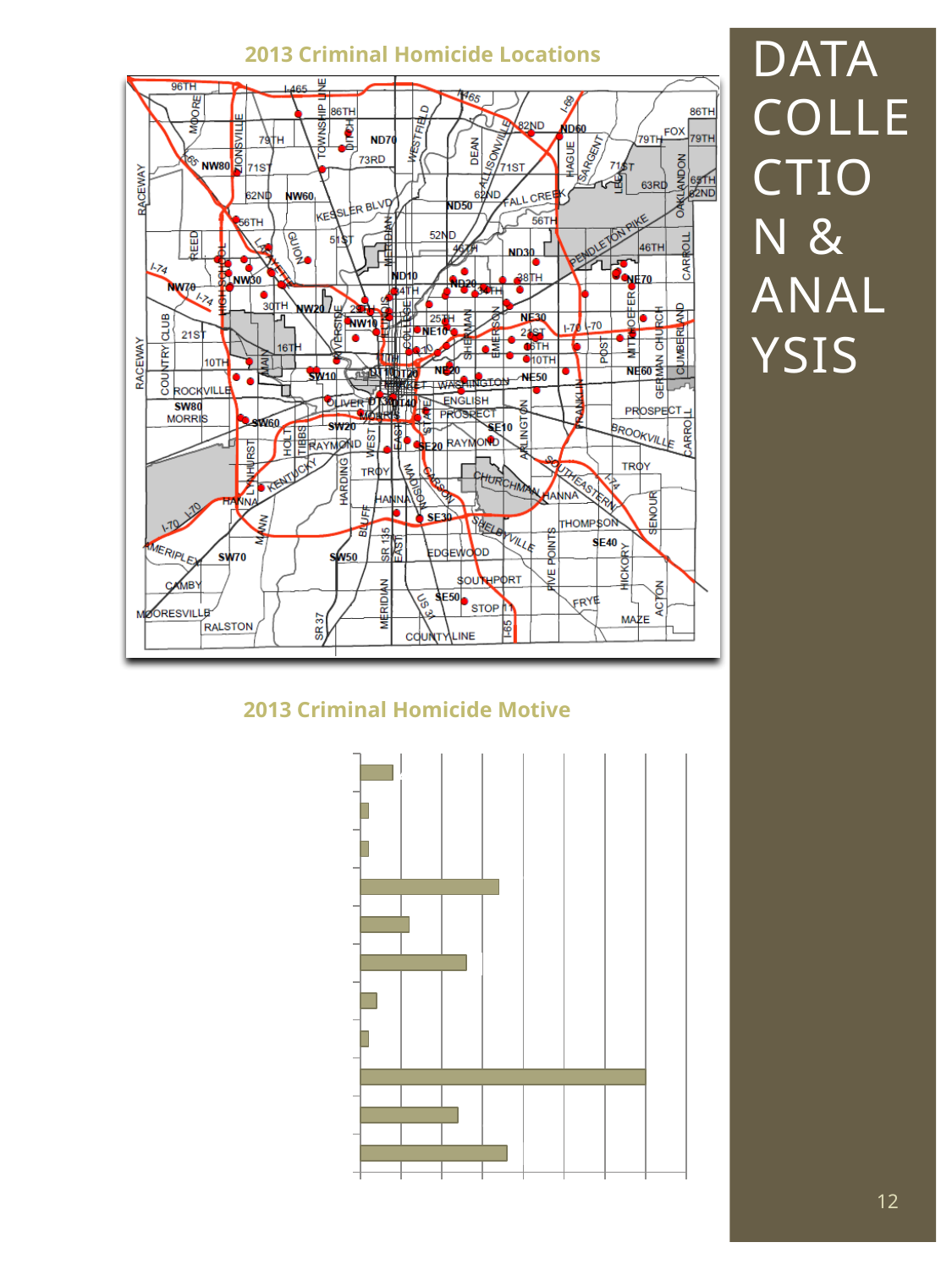
What kind of chart is the '2013 Criminal Homicide Motive' chart? bar chart What is the title of the bar chart at the bottom of the slide? 2013 Criminal Homicide Motive How many bars are plotted in the '2013 Criminal Homicide Motive' chart? 11 In the '2013 Criminal Homicide Motive' chart, which bar is the longest, counting from the top? the ninth bar Are the bars in the '2013 Criminal Homicide Motive' chart horizontal or vertical? horizontal